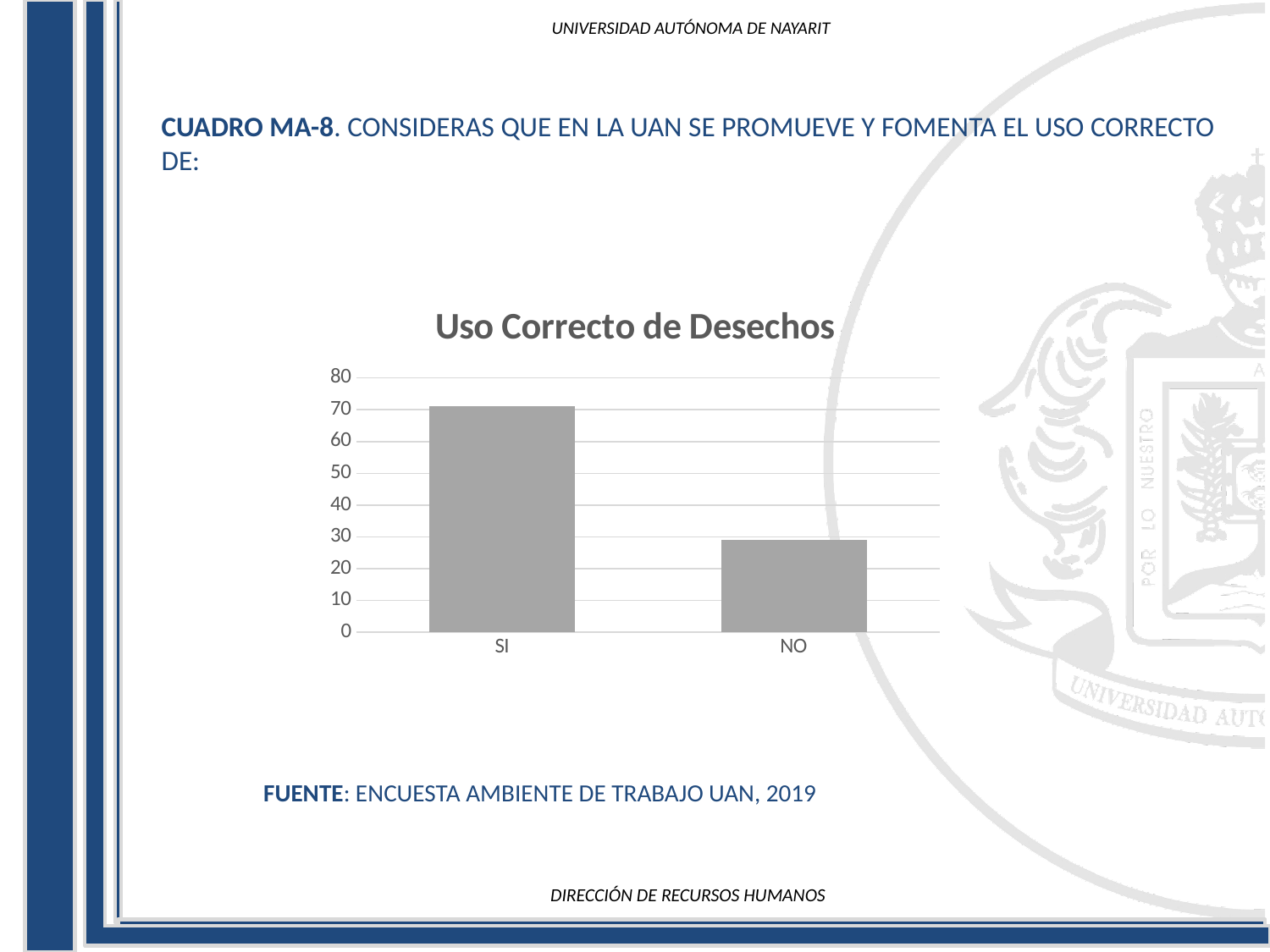
Which is larger, the value for SI or the value for NO? SI Is the value for SI greater or less than 80? less Which category has the highest value in the chart? SI What type of chart is shown on the slide? bar chart How many categories are shown on the x axis of the chart? 2 Is the value for NO greater or less than 20? greater Which category has the lowest value in the chart? NO Is the value for NO greater or less than 40? less What is the title of the chart? Uso Correcto de Desechos What is the highest value shown on the y axis of the chart? 80